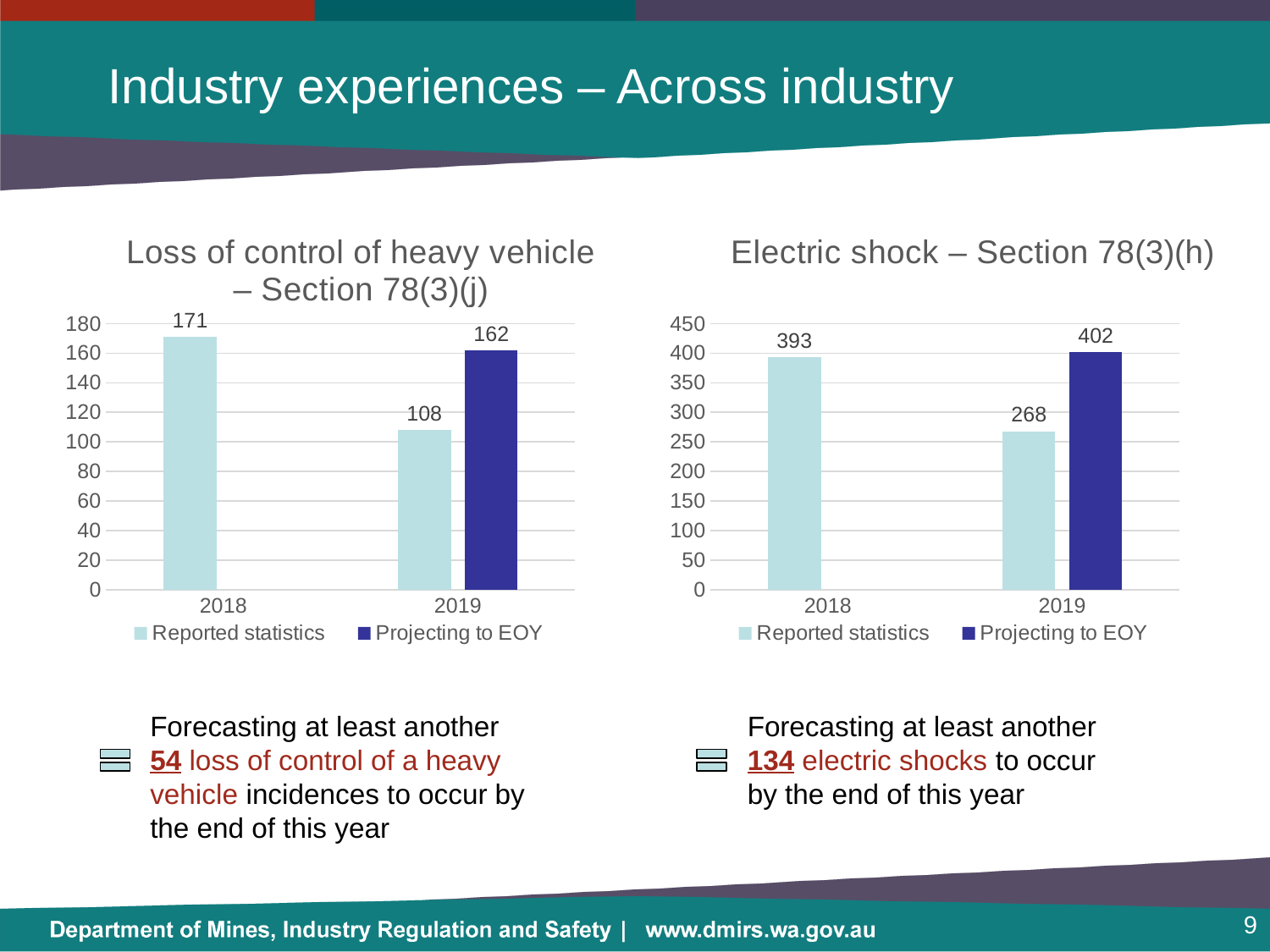
In the 'Electric shock – Section 78(3)(h)' chart, which is larger: the 2018 Reported statistics value or the 2019 Projecting to EOY value? 2019 Projecting to EOY In the 'Electric shock – Section 78(3)(h)' chart, what is the Reported statistics value for 2019? 268 In the 'Loss of control of heavy vehicle – Section 78(3)(j)' chart, what colour are the Projecting to EOY bars? Dark blue How many series does the legend of the 'Electric shock – Section 78(3)(h)' chart list? 2 In the 'Electric shock – Section 78(3)(h)' chart, what is the Projecting to EOY value for 2019? 402 What type of chart is the 'Loss of control of heavy vehicle – Section 78(3)(j)' chart? Bar chart In the 'Loss of control of heavy vehicle – Section 78(3)(j)' chart, what is the Reported statistics value for 2018? 171 In the 'Electric shock – Section 78(3)(h)' chart, what is the difference between the 2019 Projecting to EOY value and the 2019 Reported statistics value? 134 In the 'Loss of control of heavy vehicle – Section 78(3)(j)' chart, which bar has the highest value? 2018 Reported statistics In the 'Loss of control of heavy vehicle – Section 78(3)(j)' chart, what is the difference between the 2019 Projecting to EOY value and the 2019 Reported statistics value? 54 In the 'Electric shock – Section 78(3)(h)' chart, which bar has the lowest value? 2019 Reported statistics In the 'Loss of control of heavy vehicle – Section 78(3)(j)' chart, what is the Projecting to EOY value for 2019? 162